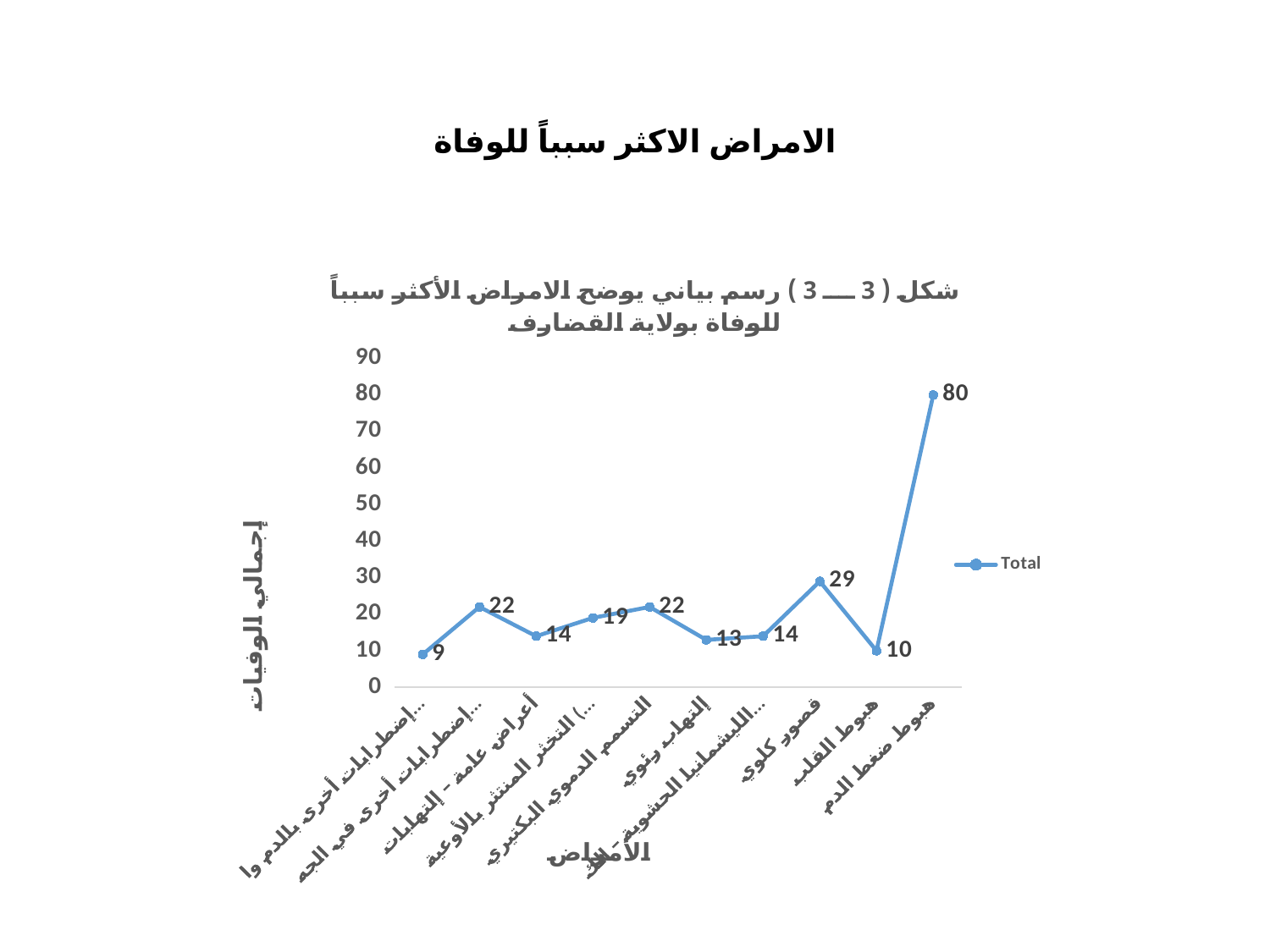
How many categories are plotted on the x axis? 10 What is the difference between the values for هبوط ضغط الدم and قصور كلوي? 51 What is the value for التهاب رئوي? 13 What type of chart is shown on the slide? line chart How many series does the legend list? 1 Is the value for هبوط ضغط الدم greater or less than 70? greater Which is larger, the value for قصور كلوي or the value for هبوط القلب? قصور كلوي Which category has the highest value? هبوط ضغط الدم What is the value for هبوط ضغط الدم? 80 What is the value for قصور كلوي? 29 What is the name of the series shown in the legend? Total What is the value for هبوط القلب? 10